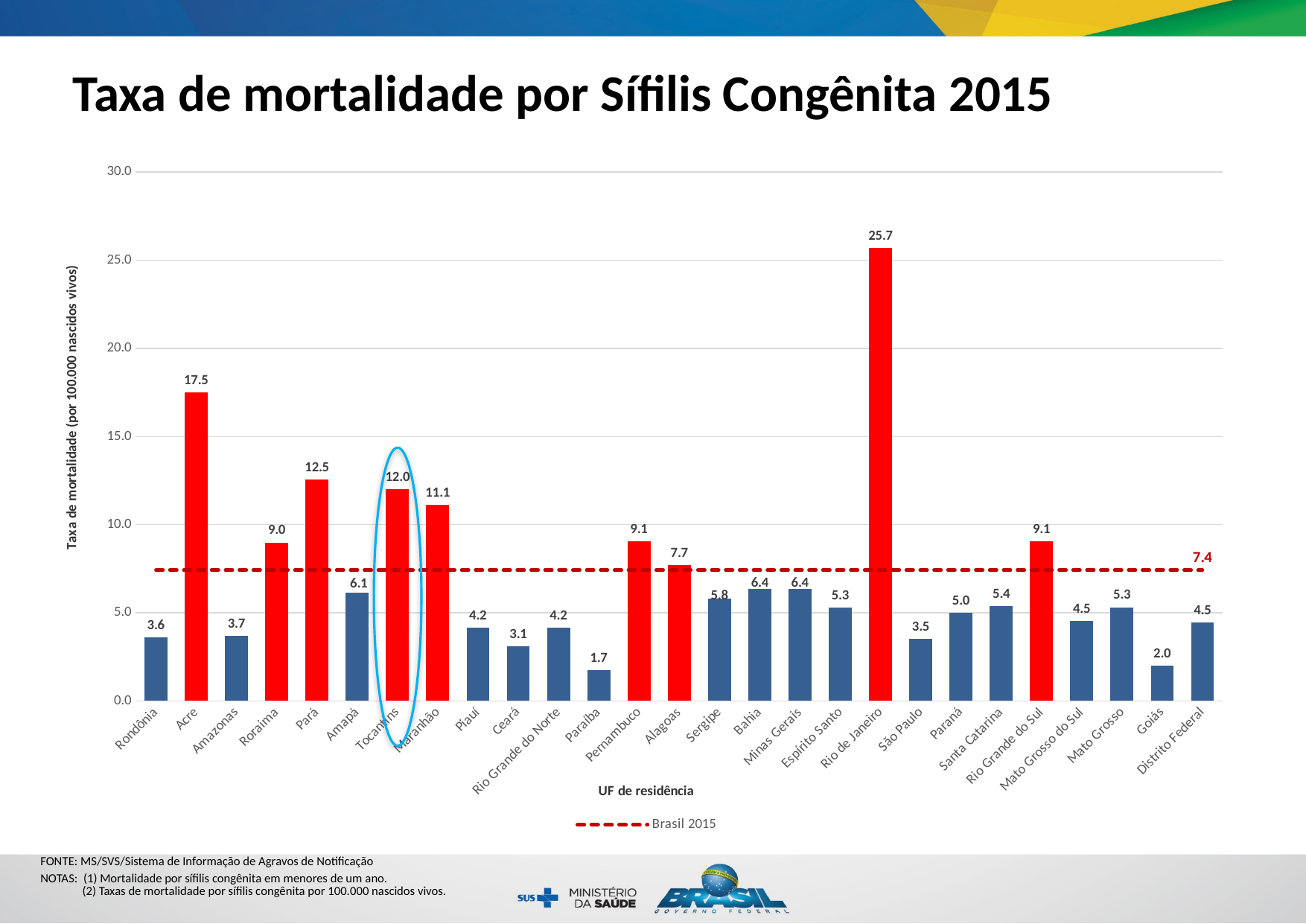
Which is larger, the value for Pará or the value for Maranhão? Pará Which UF has the highest mortality rate? Rio de Janeiro What is the label of the x axis? UF de residência Which UF has the lowest mortality rate? Paraíba What is the difference between the values for Rio de Janeiro and Acre? 8.2 What kind of chart is shown on the slide? Bar chart How many UFs (bars) are shown on the chart? 27 Is the value for Pernambuco greater or less than 5.0? greater What is the value for Tocantins, the bar circled in blue? 12.0 What is the value of the dashed 'Brasil 2015' reference line? 7.4 How many entries does the legend list? 1 What is the value for Rio de Janeiro? 25.7